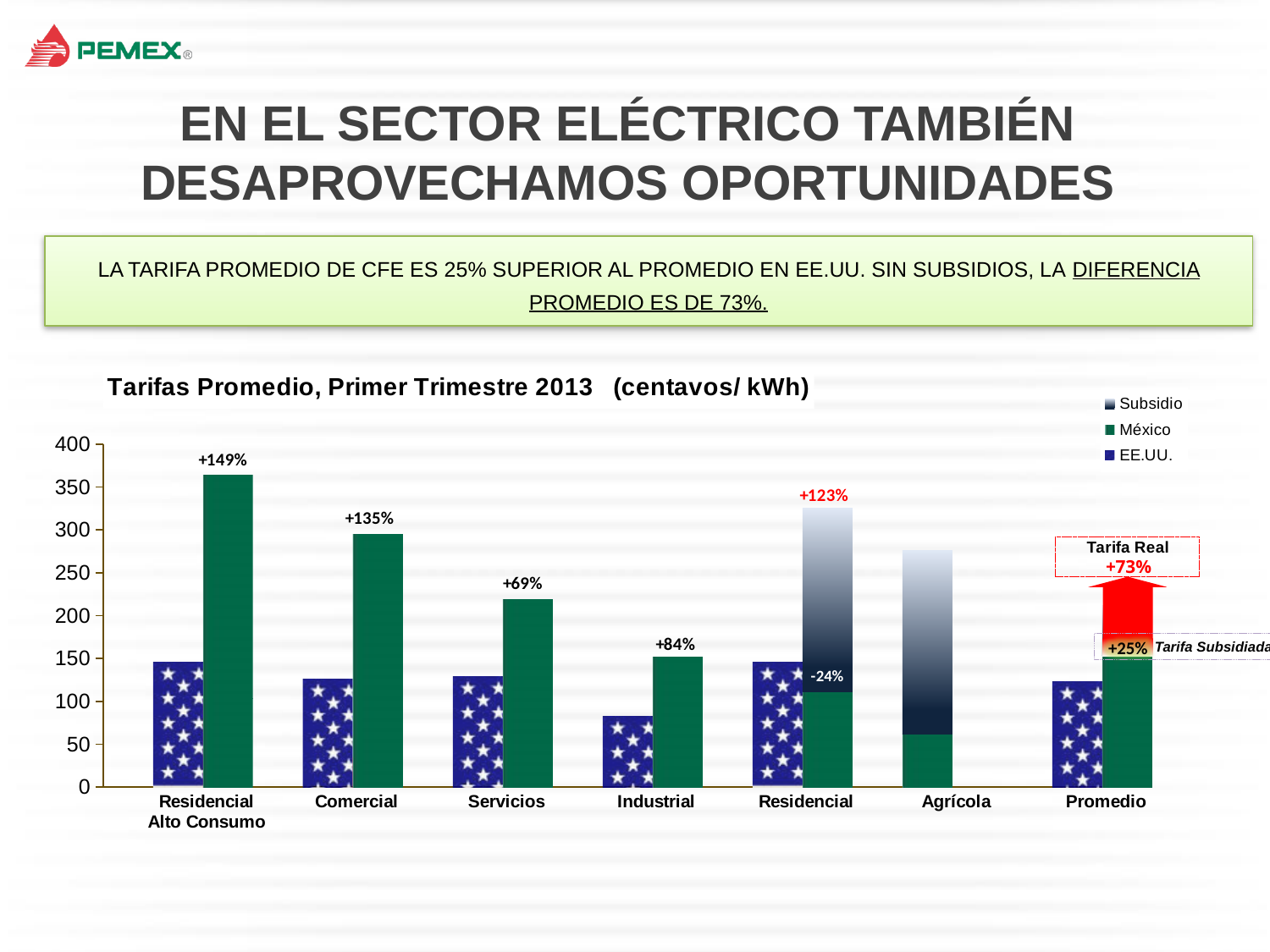
Is the México value for Residencial Alto Consumo greater or less than 350? greater What kind of chart is shown on the slide? bar chart What is the title of the chart? Tarifas Promedio, Primer Trimestre 2013 (centavos/ kWh) What percentage label is shown above the Residencial Alto Consumo bars? +149% What percentage label is shown above the Industrial bars? +84% What percentage label is shown inside the Residencial México bar? -24% How many categories are shown on the x axis of the chart? 7 Which category has the tallest México bar? Residencial Alto Consumo Which category has the shortest México bar? Agrícola What percentage label is shown above the Comercial bars? +135% How many series does the chart legend list? 3 What percentage label is shown above the Servicios bars? +69%